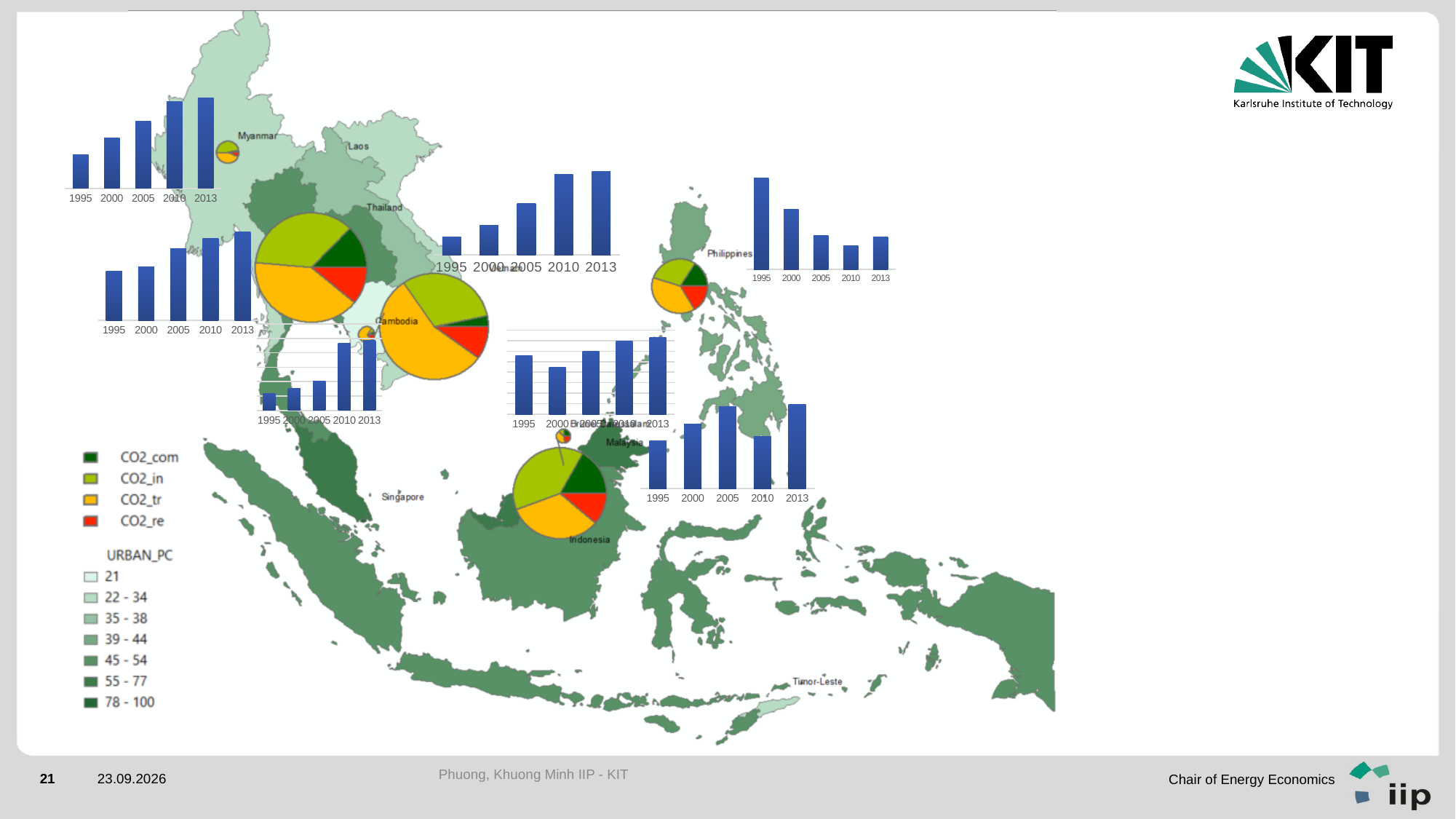
In the bar chart over Indonesia at the bottom right, is the bar for 2005 taller or shorter than the bar for 2010? taller Do the bars in the bar chart over Myanmar in the top-left rise or fall from 1995 to 2013? rise In the bar chart next to the Philippines on the right, is the bar for 1995 taller or shorter than the bar for 2013? taller In the bar chart next to the Philippines on the right, which year has the shortest bar? 2010 In the bar chart over Myanmar in the top-left, which year has the shortest bar? 1995 In the bar chart near Brunei in the centre of the map, which year has the shortest bar? 2000 How many CO2 categories does the pie chart legend list? 4 In the bar chart over Indonesia at the bottom right, which year has the tallest bar? 2013 What kind of chart is placed over Myanmar in the top-left of the map? bar chart In the bar chart next to the Philippines on the right, which year has the tallest bar? 1995 How many years are shown on the x axis of the bar chart over Myanmar in the top-left? 5 In the bar chart over Myanmar in the top-left, which year has the tallest bar? 2013